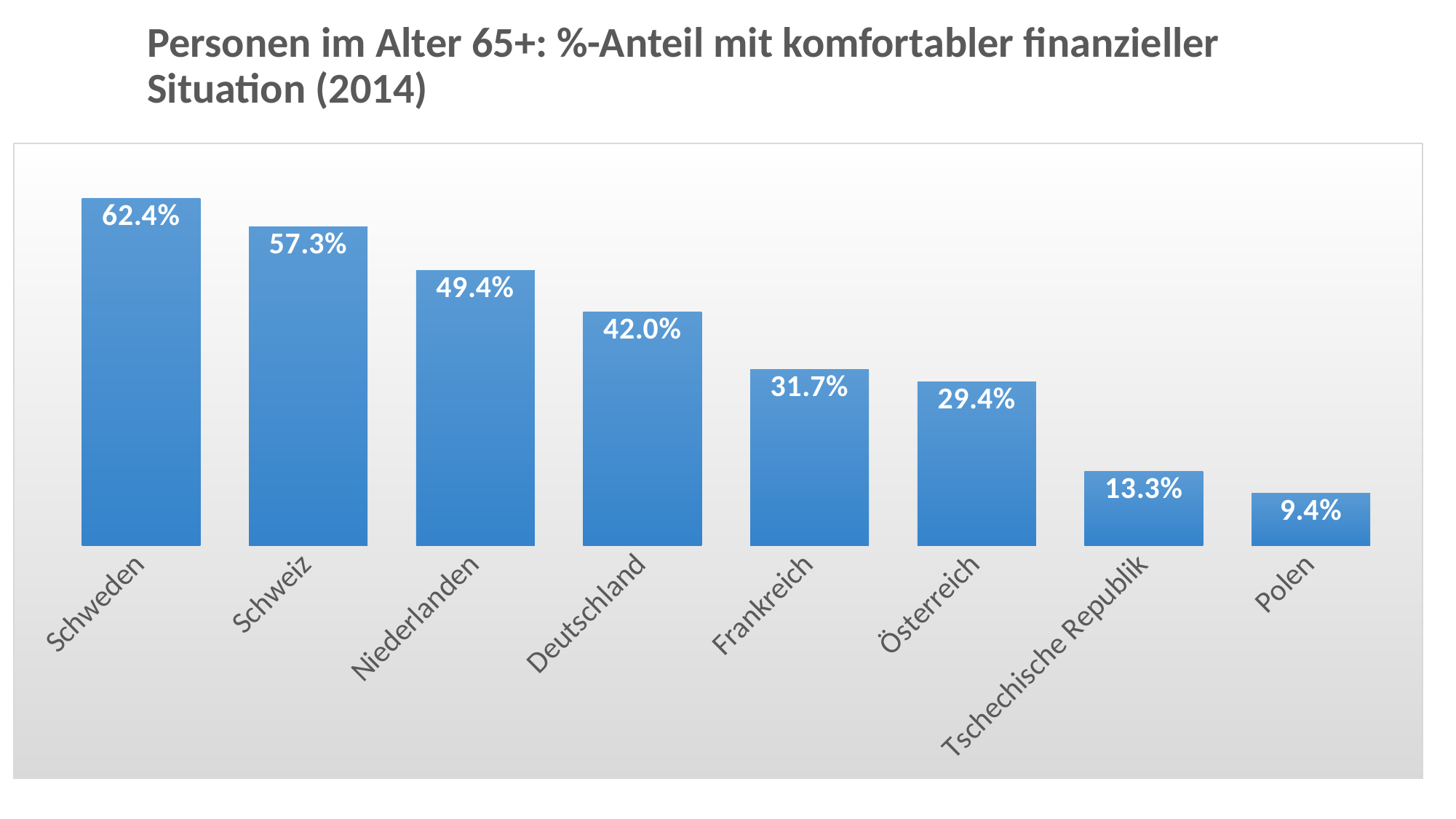
What is the difference between the values for Frankreich and Österreich? 2.3% Do the values rise or fall from left to right along the x axis? Fall Which is larger, the value for Deutschland or the value for Frankreich? Deutschland Which country has the lowest value? Polen What kind of chart is shown on the slide? Bar chart Which country has the highest value? Schweden What is the value for Deutschland? 42.0% What is the value for Tschechische Republik? 13.3% How many countries are shown in the chart? 8 What year is given in the chart title? 2014 What is the difference between the values for Schweiz and Niederlanden? 7.9% What is the value for Schweden? 62.4%